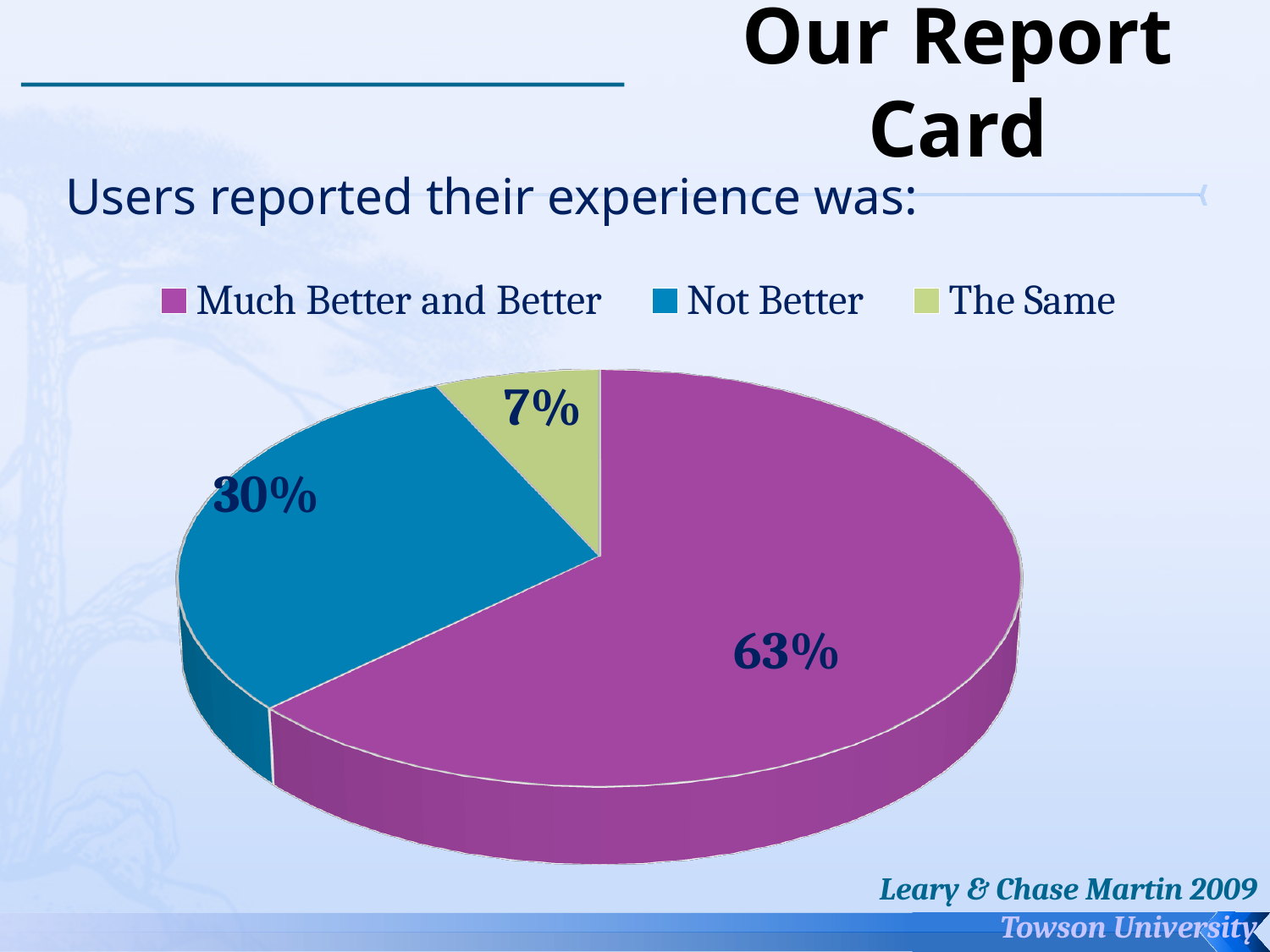
How many percentage points larger is the Not Better slice than The Same slice? 23 What kind of chart is shown on the slide? pie chart How many percentage points larger is the Much Better and Better slice than the Not Better slice? 33 Which is larger, the Not Better slice or The Same slice? Not Better Which category has the smallest slice of the pie? The Same What share of users reported their experience was Not Better? 30% How many categories does the pie chart have? 3 What share of users reported their experience was The Same? 7% Which category has the largest slice of the pie? Much Better and Better What colour is the slice for Not Better? blue What share of users reported their experience was Much Better and Better? 63% Which legend entry is shown in green? The Same